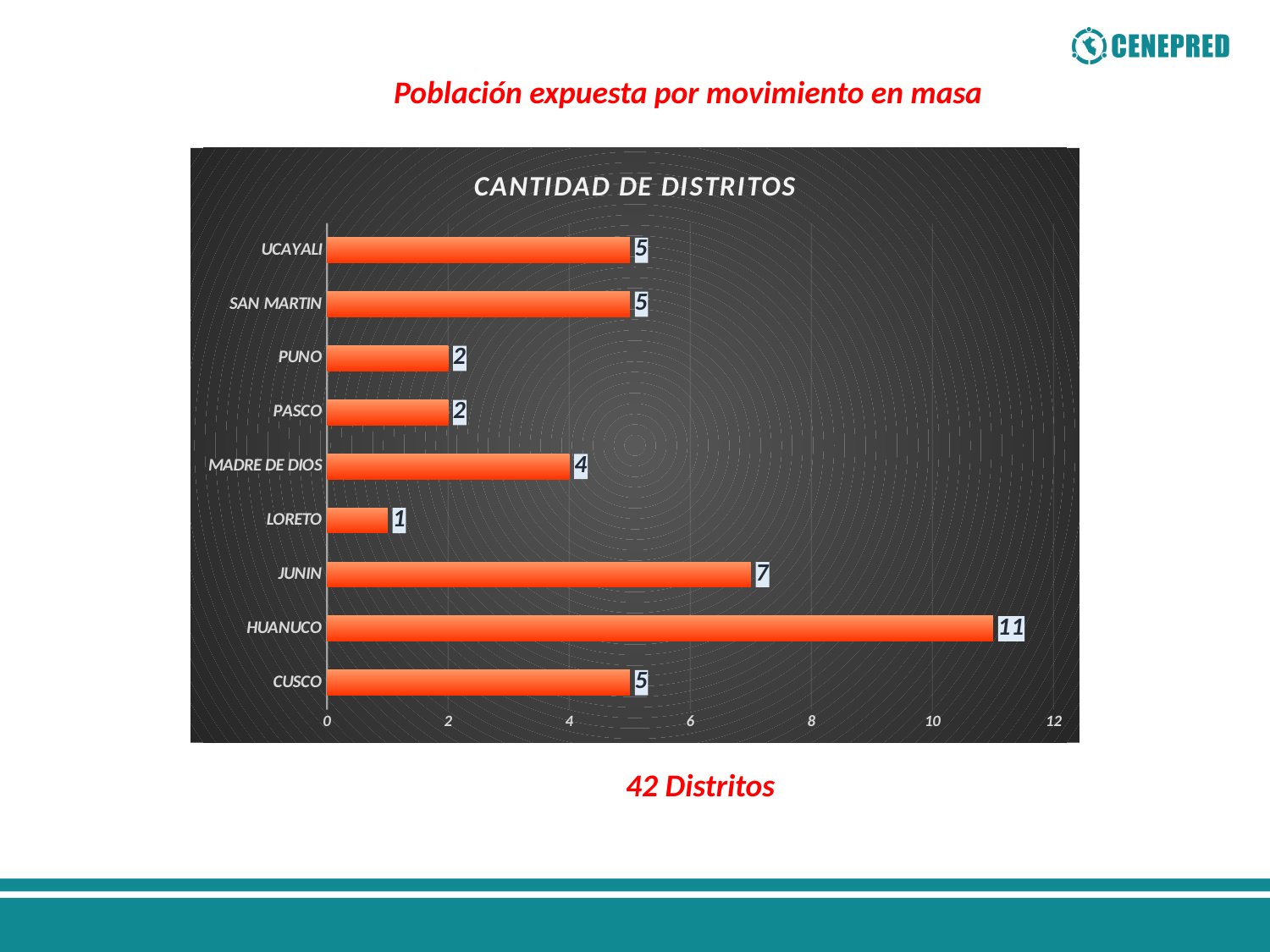
Which is larger, the value for JUNIN or the value for UCAYALI? JUNIN What kind of chart is shown on the slide? bar chart What is the value for LORETO? 1 What is the value for MADRE DE DIOS? 4 How many categories are shown in the chart? 9 Which category has the highest value? HUANUCO What is the value for PUNO? 2 Which category has the lowest value? LORETO What is the title of the chart? CANTIDAD DE DISTRITOS Is the value for HUANUCO greater or less than 10? greater What is the difference between the values for HUANUCO and JUNIN? 4 What is the value for HUANUCO? 11